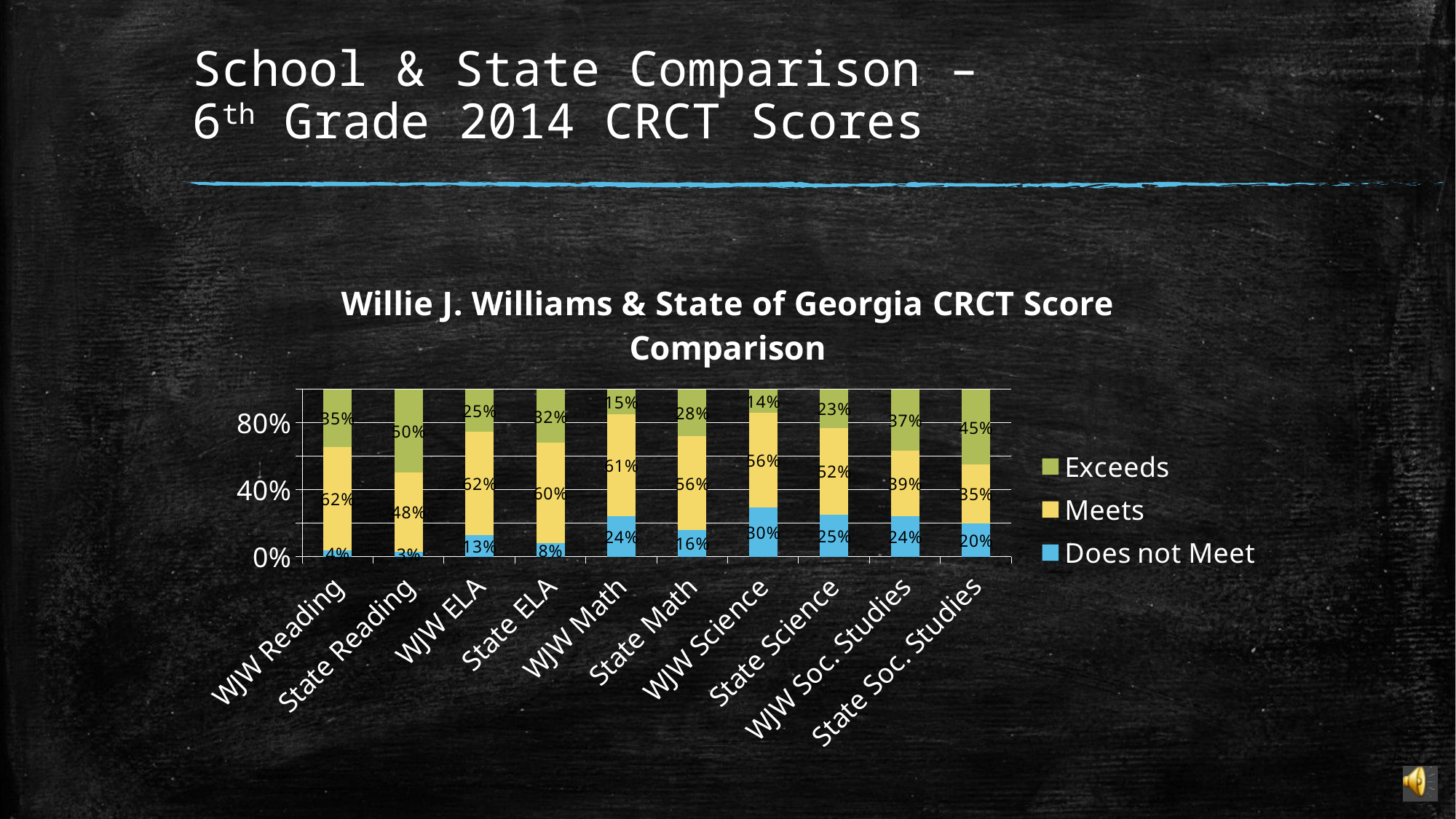
What is the Meets value for WJW Soc. Studies? 39% How many categories are shown on the x axis? 10 What is the Exceeds value for State Reading? 50% Which category has the highest Does not Meet value? WJW Science What kind of chart is shown on the slide? Stacked bar chart Which category has the lowest Does not Meet value? State Reading Which has a larger Meets value, WJW Math or State Math? WJW Math What is the difference between the Exceeds values for State Reading and WJW Reading? 15% Which category has the highest Exceeds value? State Reading What is the Does not Meet value for WJW Science? 30% How many series does the legend list? 3 What are the three entries in the chart's legend? Exceeds, Meets, Does not Meet